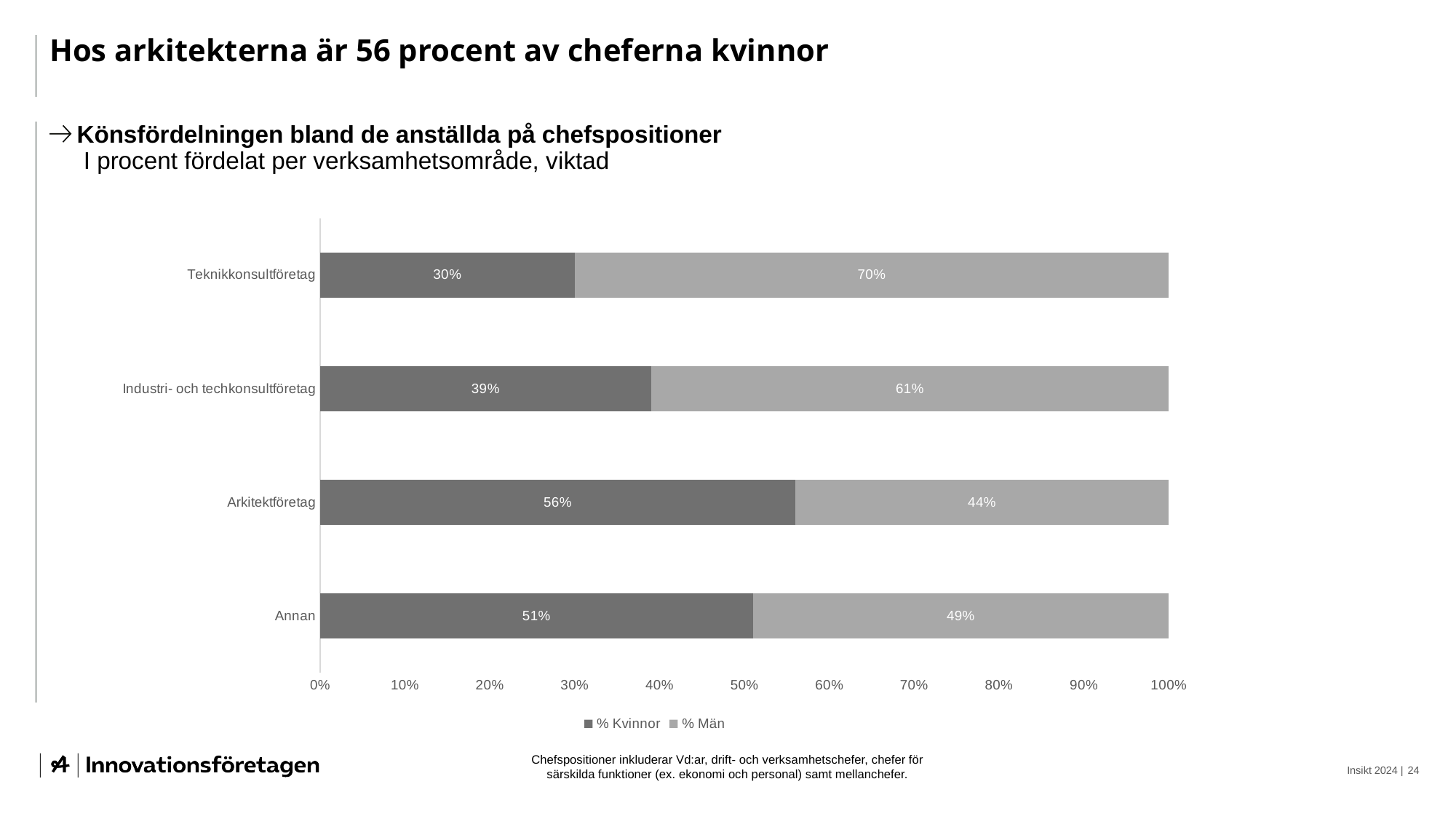
Which category has the lowest % Kvinnor value? Teknikkonsultföretag What is the total of the stacked bar for Annan? 100% What is the % Män value for Annan? 49% What is the % Kvinnor value for Teknikkonsultföretag? 30% What is the % Kvinnor value for Arkitektföretag? 56% What is the % Män value for Industri- och techkonsultföretag? 61% How many series does the legend list? 2 How many categories are shown in the chart? 4 Which category has the highest % Kvinnor value? Arkitektföretag What is the difference between the % Män values for Teknikkonsultföretag and Arkitektföretag? 26 percentage points What kind of chart is shown on the slide? Stacked bar chart Which is larger: the % Kvinnor value for Industri- och techkonsultföretag or for Annan? Annan